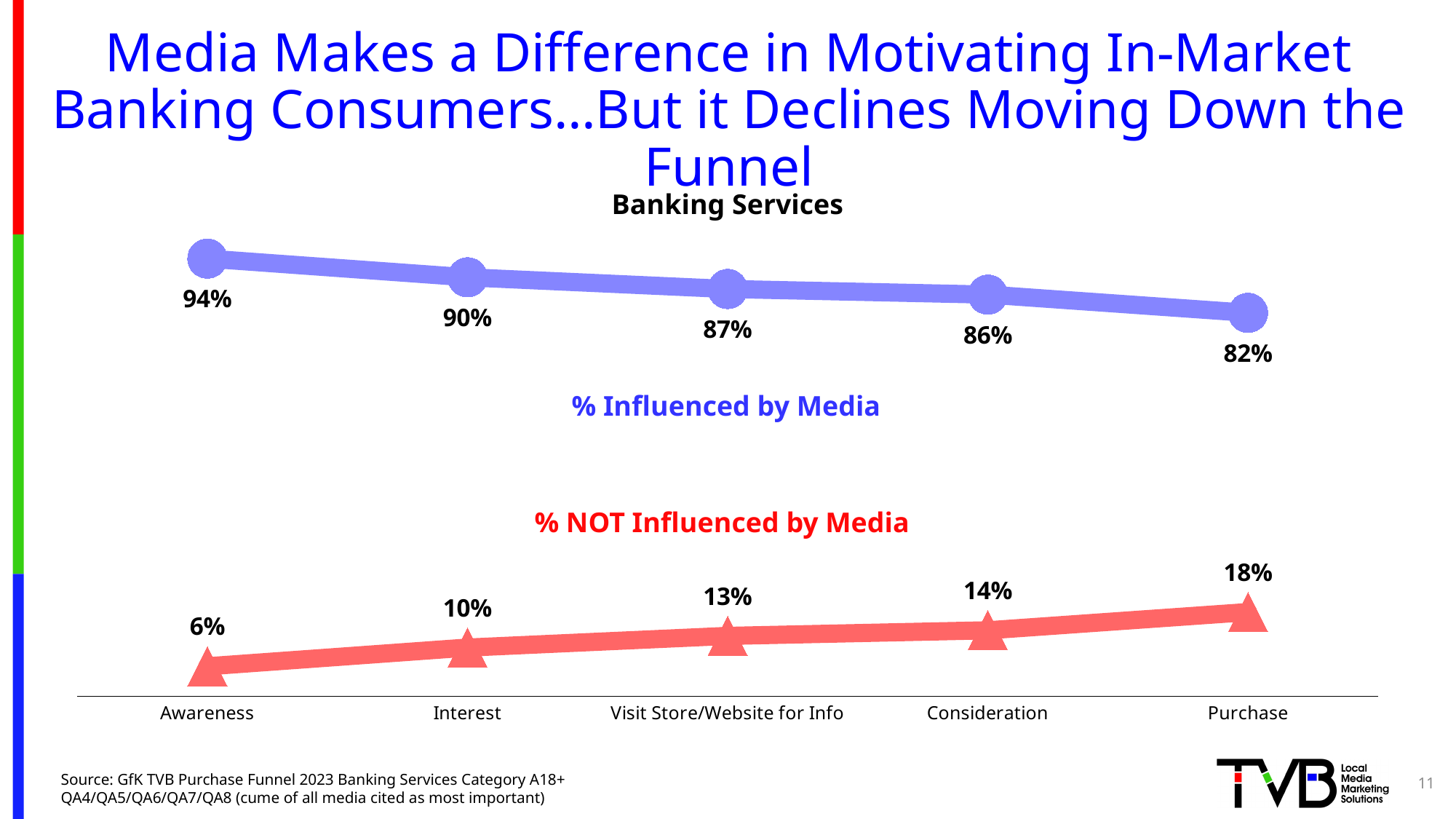
What is the % NOT Influenced by Media value at the Purchase stage? 18% What type of chart is shown on the slide? Line chart What is the % Influenced by Media value for Consideration? 86% What is the difference between the % Influenced by Media at Awareness and at Purchase? 12 percentage points What percentage of banking consumers are influenced by media at the Awareness stage? 94% At which funnel stage is the % NOT Influenced by Media lowest? Awareness At which funnel stage is the % Influenced by Media highest? Awareness How many data series are plotted on the chart? 2 Does the % Influenced by Media rise or fall moving from Awareness to Purchase? Fall Which is larger: the % NOT Influenced by Media at Interest or at Consideration? Consideration How many funnel stages are shown on the x axis? 5 What is the % NOT Influenced by Media value at Visit Store/Website for Info? 13%